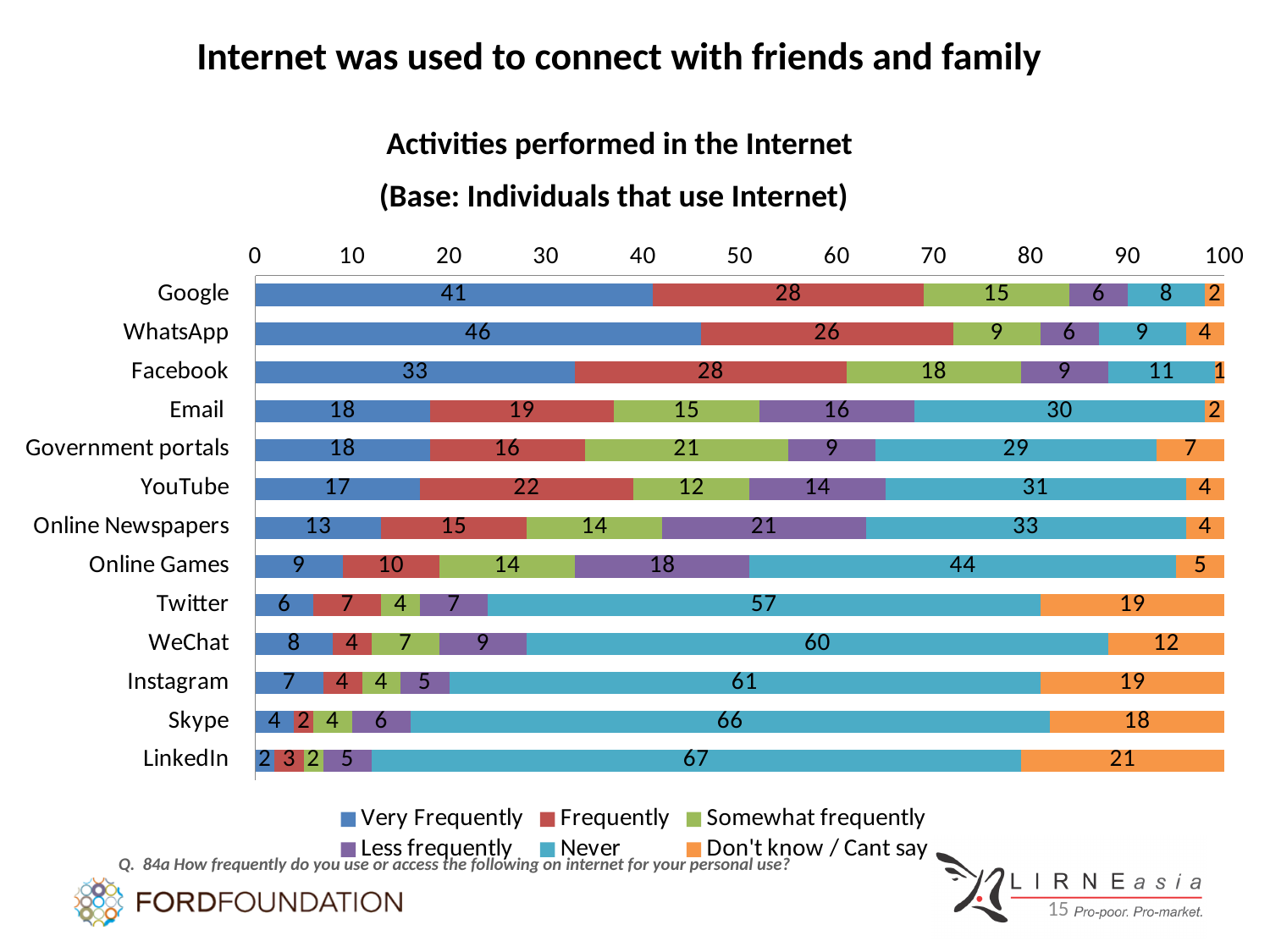
Which activity has the highest 'Very Frequently' value? WhatsApp How many series does the legend list? 6 Which has a larger 'Frequently' value, YouTube or Email? YouTube What is the total of the stacked bar for Facebook? 100 What is the 'Don't know / Cant say' value for Government portals? 7 What is the 'Never' value for LinkedIn? 67 What is the 'Very Frequently' value for WhatsApp? 46 Which activity has the lowest 'Never' value? Google What is the subtitle shown above the chart, in parentheses? (Base: Individuals that use Internet) What is the difference between the 'Never' values for Skype and Twitter? 9 What type of chart is shown on the slide? Stacked bar chart How many activities (categories) are listed on the chart? 13